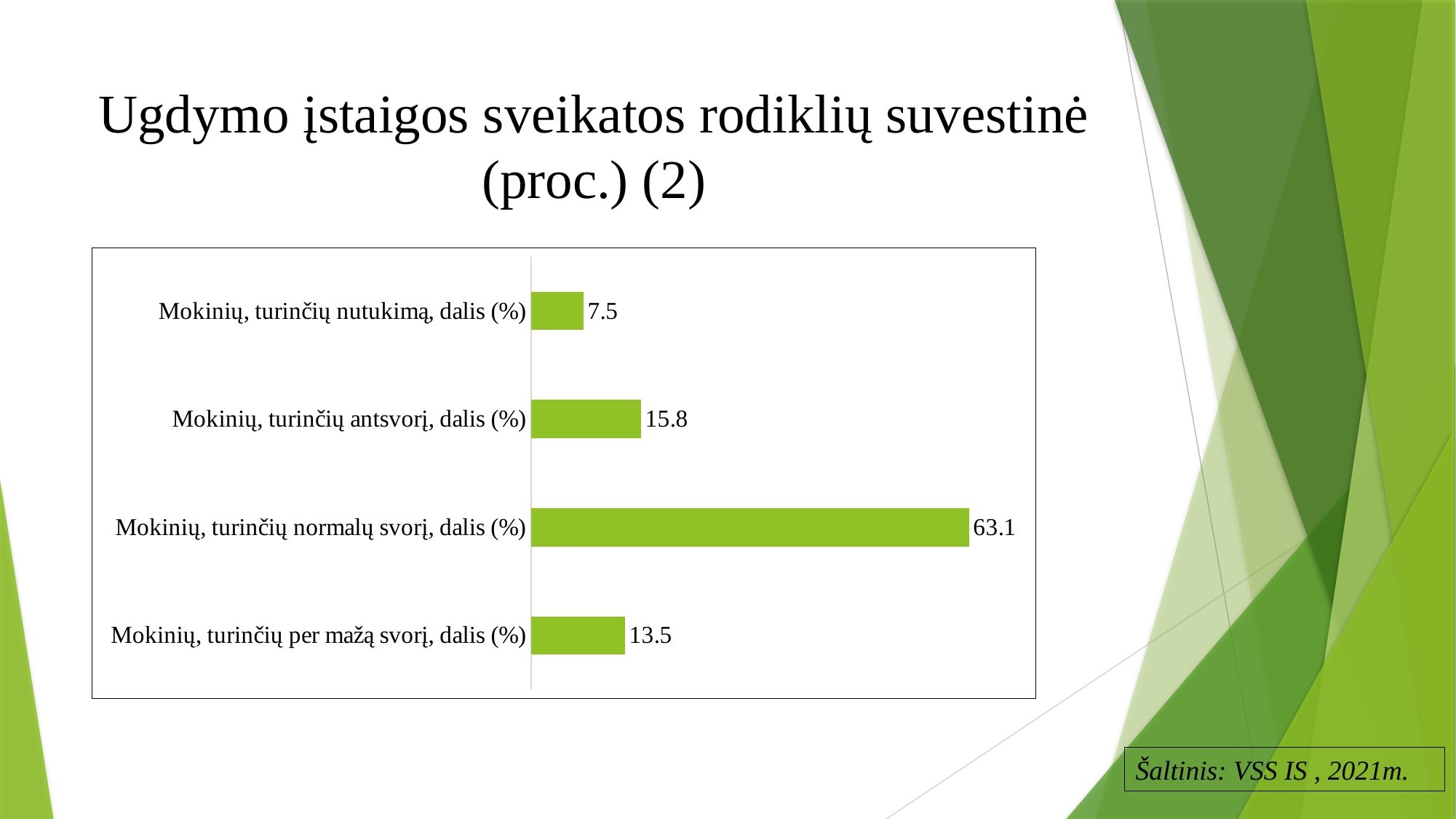
Which category has the highest value? Mokinių, turinčių normalų svorį, dalis (%) What is the difference between the values for "Mokinių, turinčių normalų svorį, dalis (%)" and "Mokinių, turinčių per mažą svorį, dalis (%)"? 49.6 What is the value for "Mokinių, turinčių antsvorį, dalis (%)"? 15.8 What is the difference between the values for "Mokinių, turinčių antsvorį, dalis (%)" and "Mokinių, turinčių nutukimą, dalis (%)"? 8.3 What colour are the bars in the chart? Green What is the value for "Mokinių, turinčių nutukimą, dalis (%)"? 7.5 What is the value for "Mokinių, turinčių normalų svorį, dalis (%)"? 63.1 Which category has the lowest value? Mokinių, turinčių nutukimą, dalis (%) How many categories are shown in the chart? 4 Which is larger: the value for "Mokinių, turinčių antsvorį, dalis (%)" or "Mokinių, turinčių per mažą svorį, dalis (%)"? Mokinių, turinčių antsvorį, dalis (%) What kind of chart is shown on the slide? Bar chart What is the value for "Mokinių, turinčių per mažą svorį, dalis (%)"? 13.5